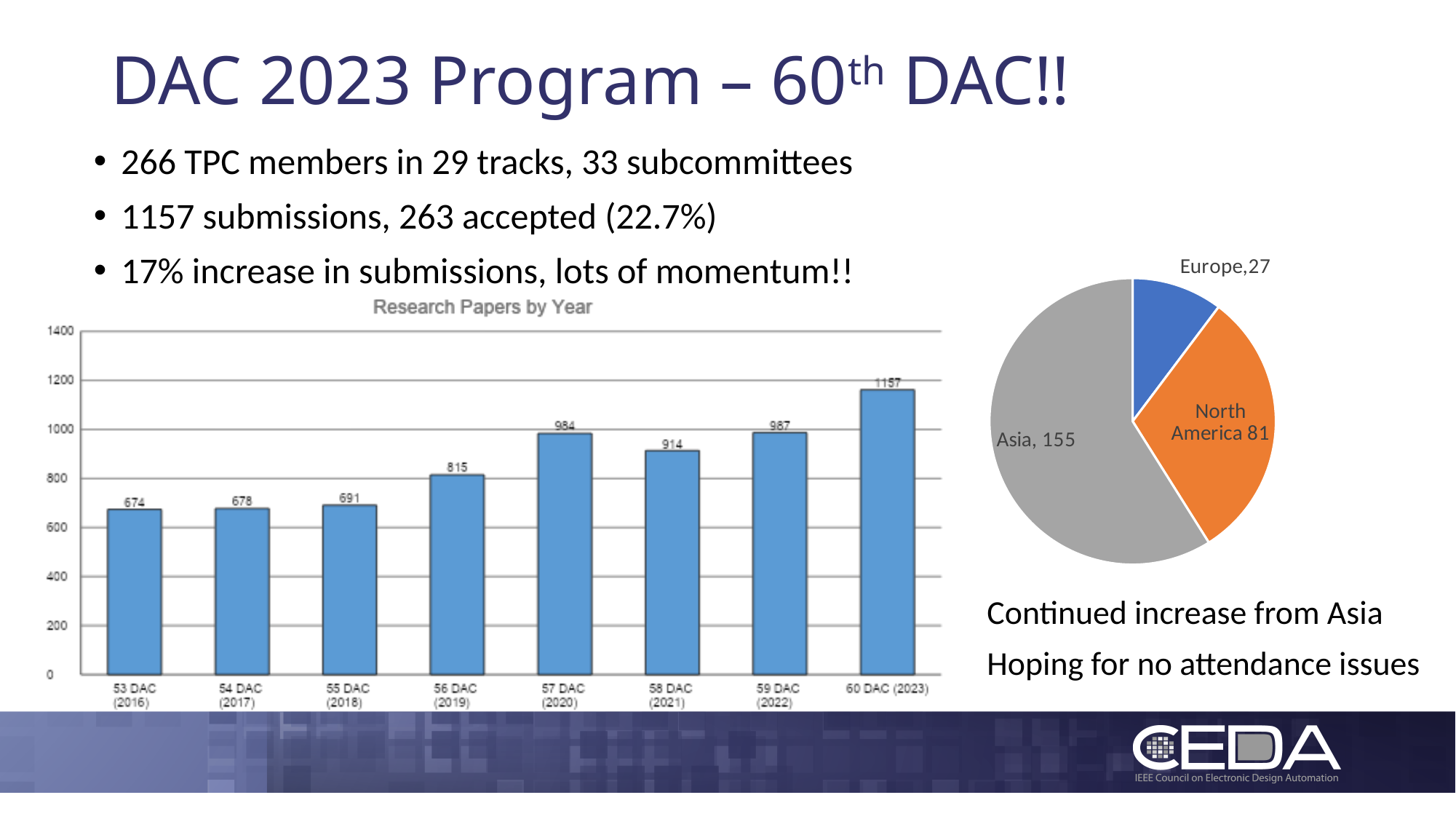
In the pie chart on the right, which region has the smallest slice? Europe In the 'Research Papers by Year' chart, how many years are shown? 8 In the 'Research Papers by Year' chart, which is larger, the value for 57 DAC (2020) or 58 DAC (2021)? 57 DAC (2020) What kind of chart is 'Research Papers by Year'? Bar chart In the 'Research Papers by Year' chart, which year has the highest value? 60 DAC (2023) In the 'Research Papers by Year' chart, what is the value for 60 DAC (2023)? 1157 In the 'Research Papers by Year' chart, what is the value for 56 DAC (2019)? 815 In the pie chart on the right, what is the difference between the values for Asia and North America? 74 In the 'Research Papers by Year' chart, which year has the lowest value? 53 DAC (2016) In the 'Research Papers by Year' chart, what is the difference between the values for 60 DAC (2023) and 59 DAC (2022)? 170 In the pie chart on the right, what is the value for Asia? 155 In the pie chart on the right, what share of the total does Asia represent? 58.9%